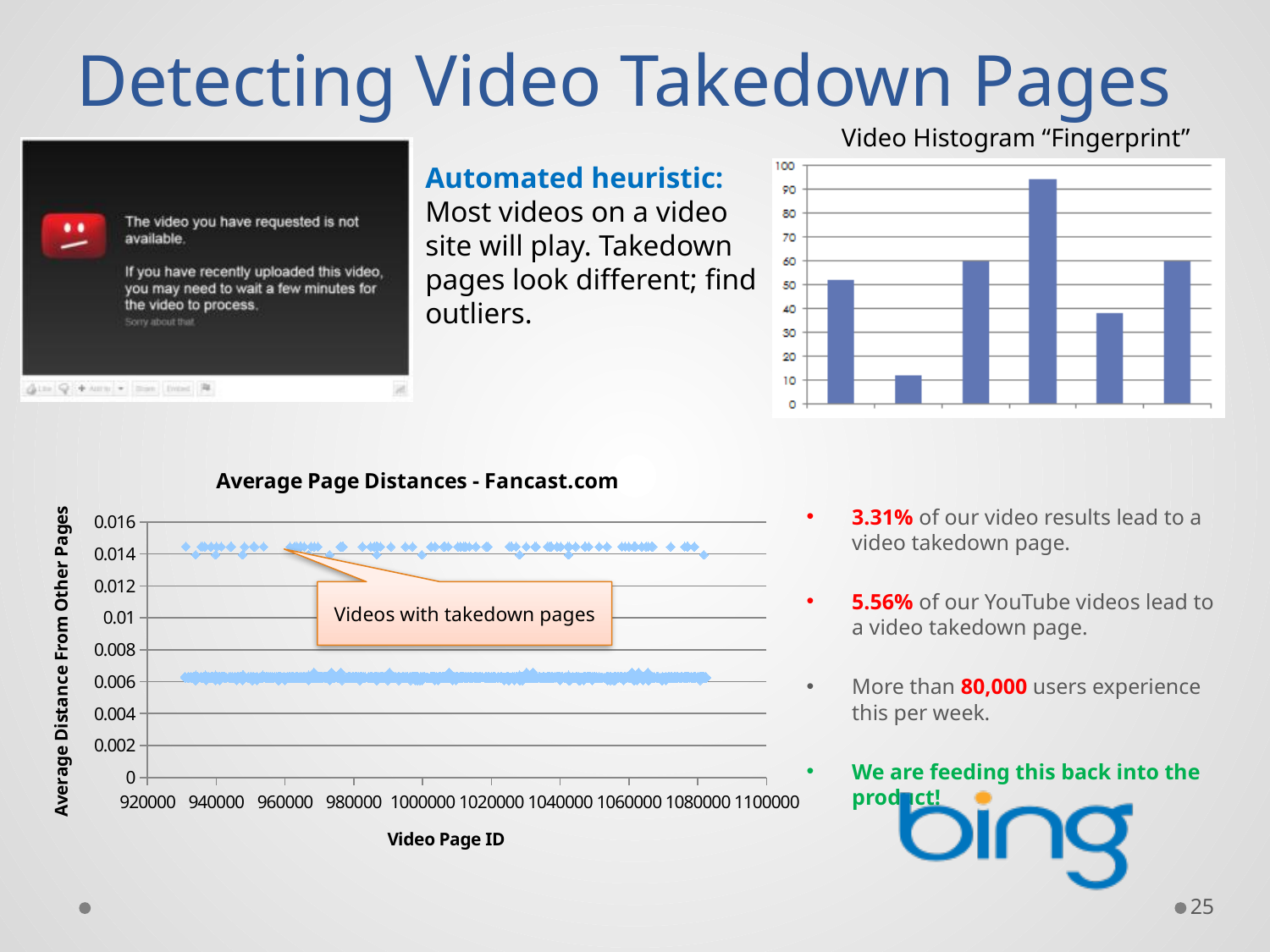
What kind of chart is the "Video Histogram "Fingerprint"" chart? bar chart In the "Average Page Distances - Fancast.com" chart, do the values of the lower band of points rise, fall, or stay flat as Video Page ID increases? stay flat What is the y-axis label of the "Average Page Distances - Fancast.com" chart? Average Distance From Other Pages How many bars are plotted in the "Video Histogram "Fingerprint"" chart? 6 In the "Video Histogram "Fingerprint"" chart, which bar from the left is the tallest? the fourth bar In the "Video Histogram "Fingerprint"" chart, which bar from the left is the shortest? the second bar In the "Video Histogram "Fingerprint"" chart, is the fifth bar taller or shorter than the third bar? shorter In the "Video Histogram "Fingerprint"" chart, is the value of the second bar greater or less than 20? less In the "Average Page Distances - Fancast.com" chart, is the lower band of points greater or less than 0.008 on the y axis? less In the "Video Histogram "Fingerprint"" chart, is the value of the fourth bar greater or less than 90? greater What kind of chart is "Average Page Distances - Fancast.com"? scatter chart